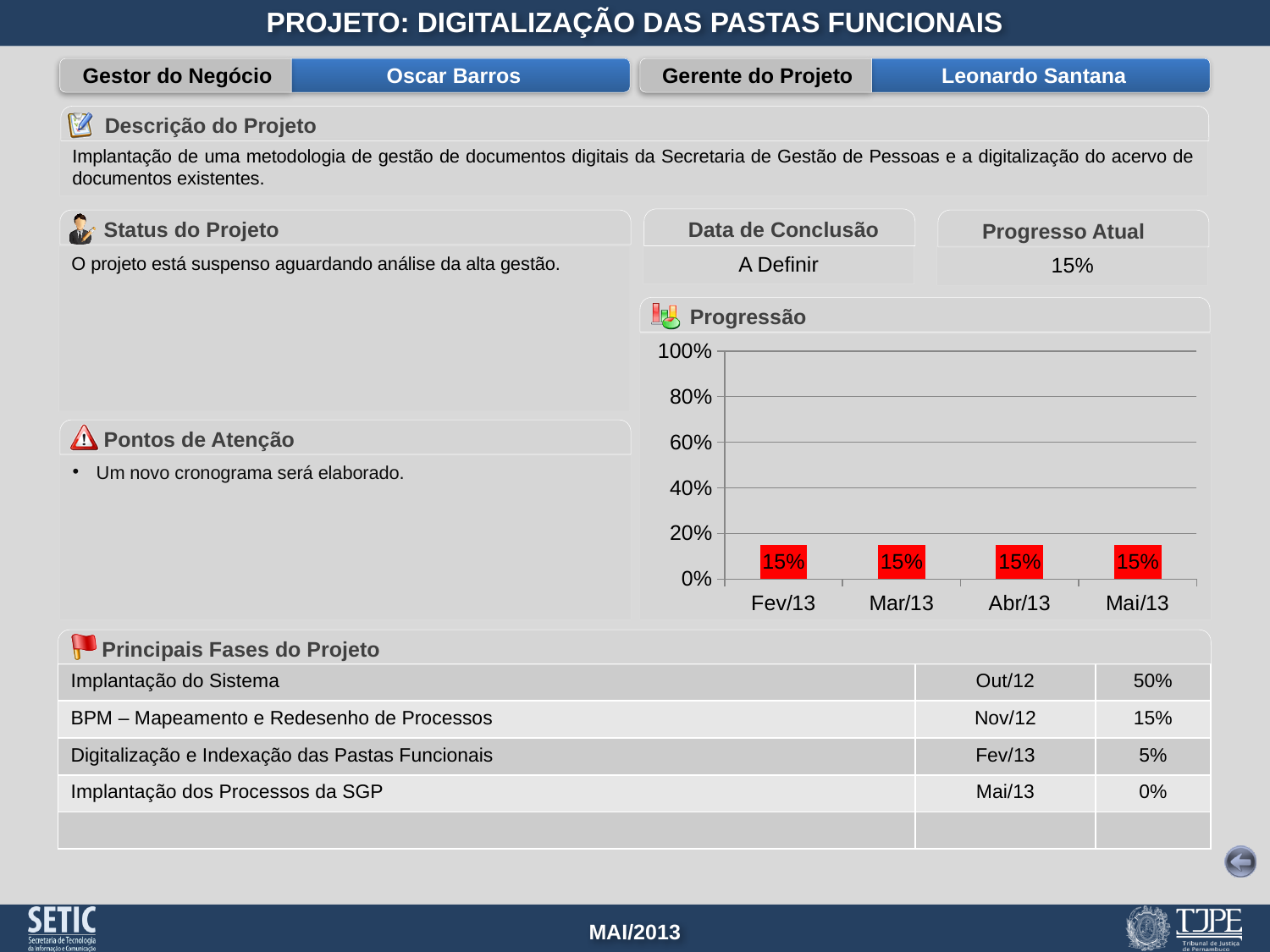
Do the values in the Progressão chart rise, fall or stay flat from Fev/13 to Mai/13? stay flat What colour are the bars in the Progressão chart? red Is the value for Abr/13 in the Progressão chart greater or less than 20%? less What is the highest value shown on the y axis of the Progressão chart? 100% What is the difference between the values for Mai/13 and Fev/13 in the Progressão chart? 0% How many months are shown on the x axis of the Progressão chart? 4 Which month is the first category on the x axis of the Progressão chart? Fev/13 What is the value for Mar/13 in the Progressão chart? 15% What is the value for Abr/13 in the Progressão chart? 15% What is the value for Mai/13 in the Progressão chart? 15% What kind of chart is the Progressão chart? bar chart What is the value for Fev/13 in the Progressão chart? 15%